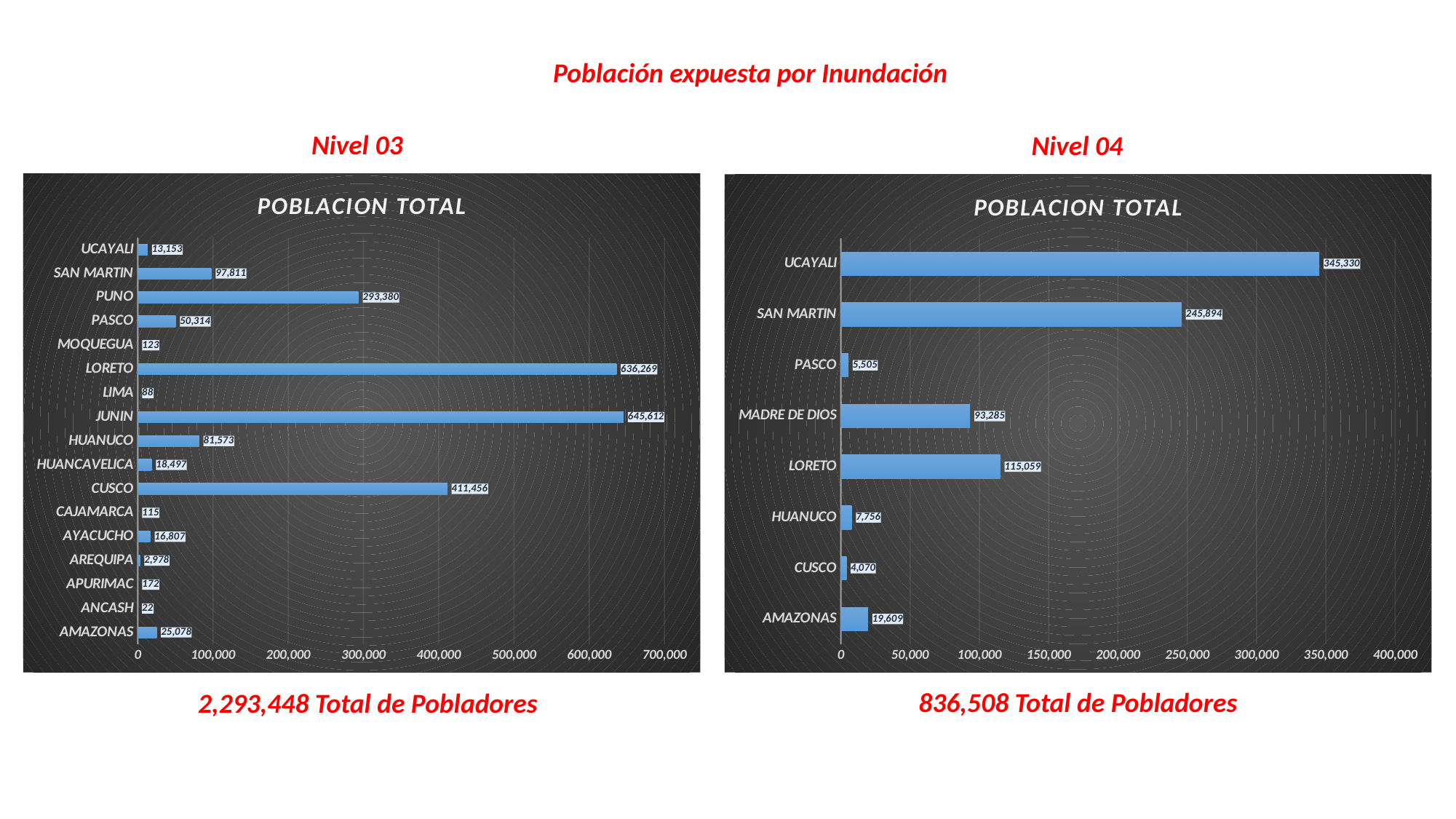
In the Nivel 03 chart (left), which category has the lowest value? ANCASH What kind of chart is the Nivel 03 chart (left)? Bar chart In the Nivel 04 chart (right), which category has the lowest value? CUSCO How many categories are shown in the Nivel 04 chart (right)? 8 In the Nivel 03 chart (left), which is larger, the value for SAN MARTIN or the value for HUANUCO? SAN MARTIN How many categories are shown in the Nivel 03 chart (left)? 17 In the Nivel 03 chart (left), which category has the highest value? JUNIN In the Nivel 04 chart (right), what is the difference between the values for UCAYALI and SAN MARTIN? 99,436 In the Nivel 03 chart (left), what is the value for PUNO? 293,380 In the Nivel 03 chart (left), what is the difference between the values for CUSCO and PUNO? 118,076 In the Nivel 04 chart (right), which category has the highest value? UCAYALI In the Nivel 04 chart (right), what is the value for MADRE DE DIOS? 93,285